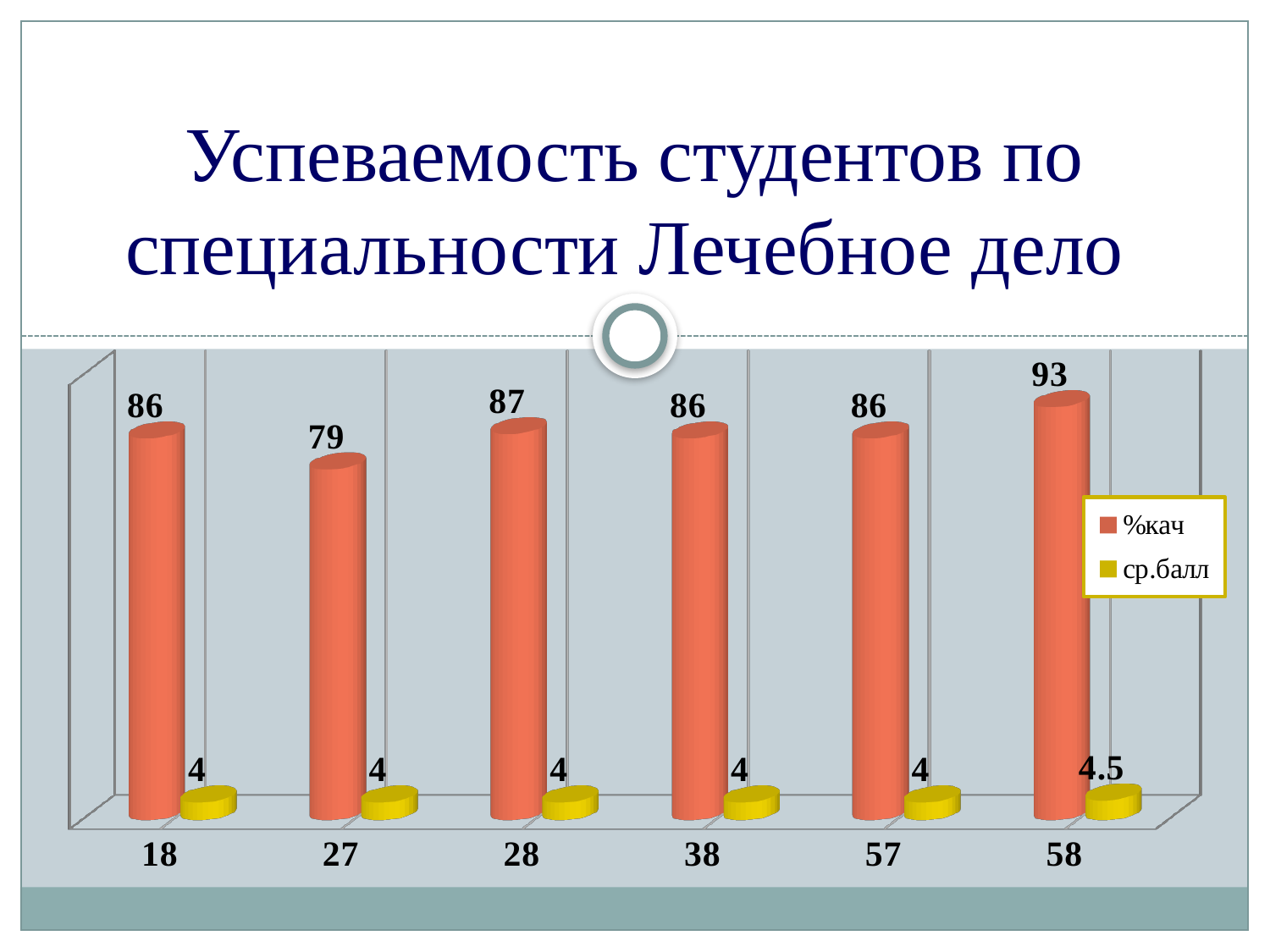
What is the ср.балл value for category 58? 4.5 Which category has the lowest %кач value? 27 What is the %кач value for category 27? 79 How many categories are shown on the x axis? 6 What colour are the ср.балл bars? yellow How many series does the legend list? 2 Which has a larger %кач value, category 28 or category 27? 28 What is the %кач value for category 18? 86 What is the difference between the %кач values for categories 58 and 27? 14 Which category has the highest %кач value? 58 What kind of chart is shown on the slide? bar chart What is the ср.балл value for category 38? 4